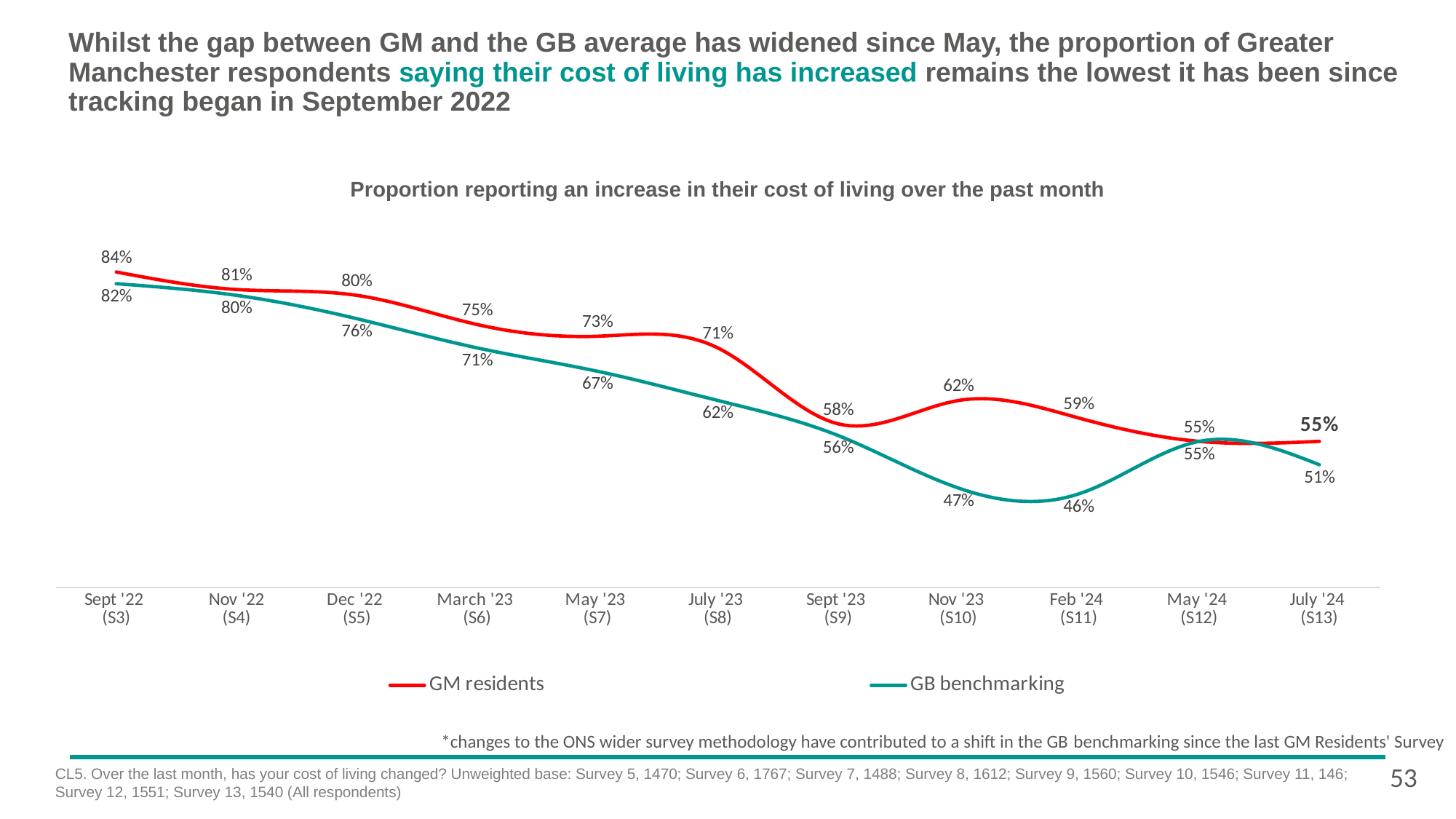
At which time point is the GM residents value highest? Sept '22 (S3) What is the value for GM residents in Sept '22 (S3)? 84% What is the difference between GM residents and GB benchmarking in Nov '23 (S10)? 15 percentage points At which time point is the GB benchmarking value lowest? Feb '24 (S11) What is the value for GM residents in July '24 (S13)? 55% What colour is the line for GB benchmarking? Teal How many series does the legend list? 2 Does the GM residents series generally rise or fall from Sept '22 to July '24? Fall What is the value for GB benchmarking in Feb '24 (S11)? 46% How many time points are plotted along the x axis? 11 What type of chart is shown on the slide? Line chart Which series has the higher value in July '24 (S13), GM residents or GB benchmarking? GM residents